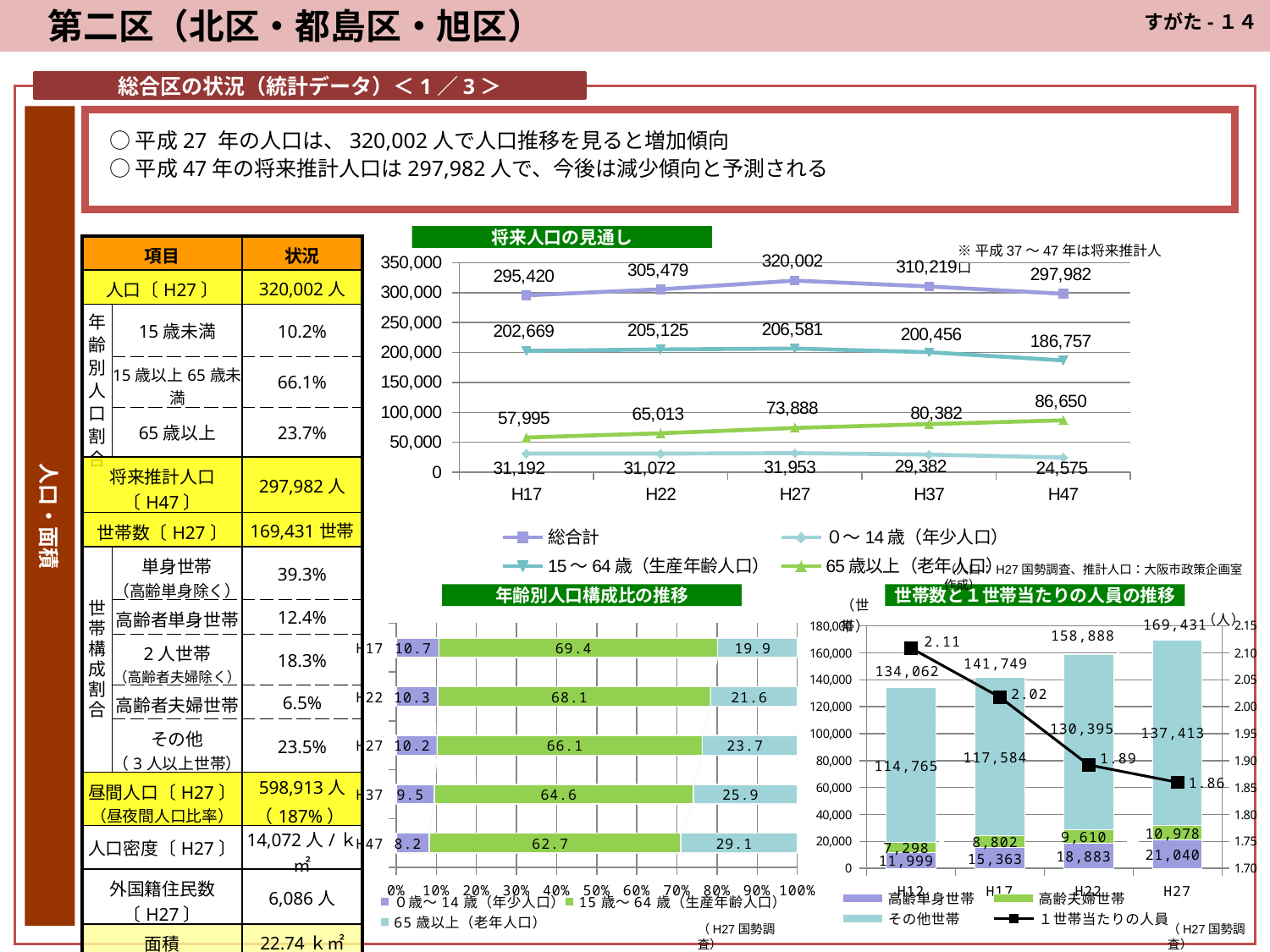
In the 将来人口の見通し chart, what is the value for 65歳以上（老年人口） in H47? 86,650 In the 年齢別人口構成比の推移 chart, what is the 15歳～64歳 share for H22? 68.1 In the 年齢別人口構成比の推移 chart, which year has the lowest 0歳～14歳 share? H47 In the 将来人口の見通し chart, do the 65歳以上 values rise or fall from H17 to H47? rise In the 世帯数と1世帯当たりの人員の推移 chart, what is the total number of households shown for H27? 169,431 In the 将来人口の見通し chart, what is the difference between the 15～64歳 values for H27 and H47? 19,824 How many series does the legend of the 将来人口の見通し chart list? 4 In the 世帯数と1世帯当たりの人員の推移 chart, which is larger: the 高齢単身世帯 value for H27 or the 高齢夫婦世帯 value for H27? 高齢単身世帯 In the 将来人口の見通し chart, which year has the highest 総合計 value? H27 In the 世帯数と1世帯当たりの人員の推移 chart, what is the 1世帯当たりの人員 value for H22? 1.89 In the 将来人口の見通し chart, what is the 総合計 value for H27? 320,002 What kind of chart is the 年齢別人口構成比の推移 chart? stacked bar chart